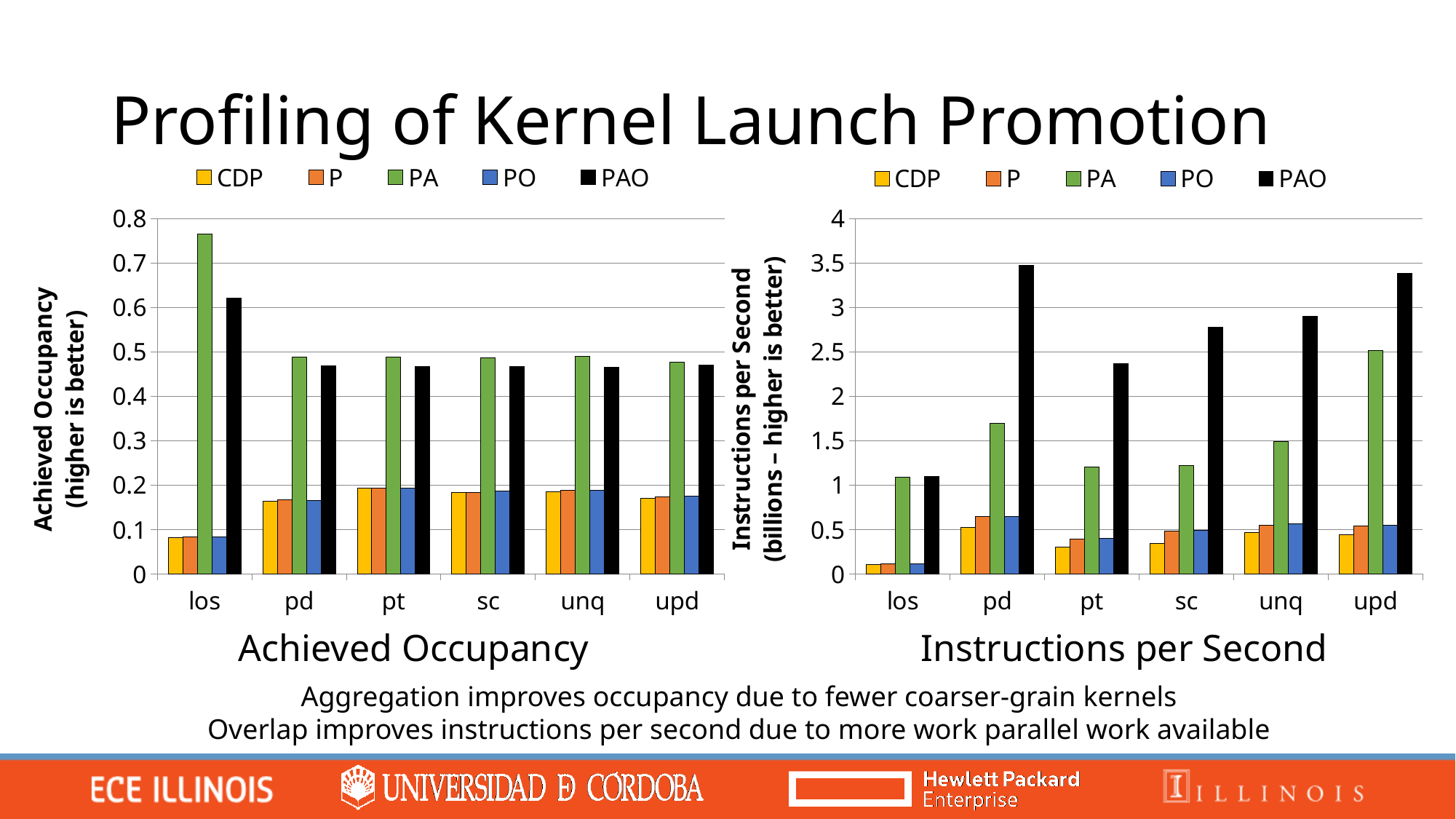
How many series does the legend of the Achieved Occupancy chart list? 5 In the Achieved Occupancy chart, is the CDP value for los greater or less than 0.1? less What is the y-axis title of the Instructions per Second chart? Instructions per Second (billions – higher is better) In the Instructions per Second chart, which category has the lowest PAO value? los What kind of chart is the Achieved Occupancy chart? bar chart In the Instructions per Second chart, which is larger: the PA value for los or the PA value for pd? pd How many categories are shown on the x axis of the Instructions per Second chart? 6 In the Achieved Occupancy chart, which series has the highest value for los? PA In the Instructions per Second chart, is the PAO value for pd greater or less than 3? greater In the Achieved Occupancy chart, which category has the highest PA value? los In the Instructions per Second chart, which series has the highest value for upd? PAO In the Achieved Occupancy chart, is the PA value for los greater or less than 0.7? greater